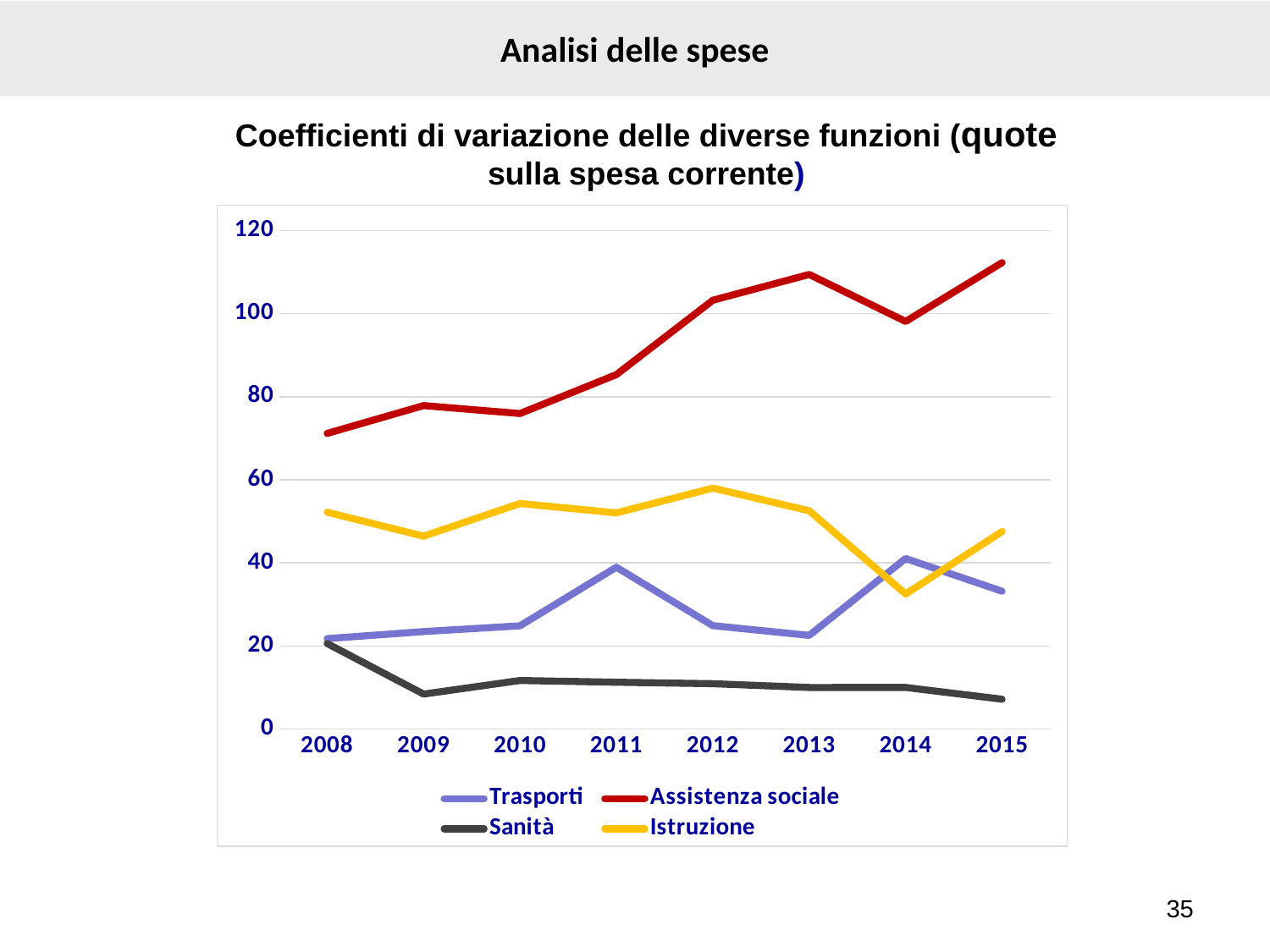
Is the value for Assistenza sociale in 2015 greater or less than 100? greater Is the value for Sanità in 2009 greater or less than 20? less Is the value for Istruzione in 2012 greater or less than 40? greater What kind of chart is shown on the slide? line chart Which series has the highest value in 2015? Assistenza sociale Does the Assistenza sociale line overall rise or fall from 2008 to 2015? rise In 2014, which is larger: Trasporti or Istruzione? Trasporti Which series has the lowest value in 2015? Sanità Does the Sanità line overall rise or fall from 2008 to 2015? fall How many series does the legend list? 4 What colour is the Istruzione line? yellow How many years are shown on the x axis? 8